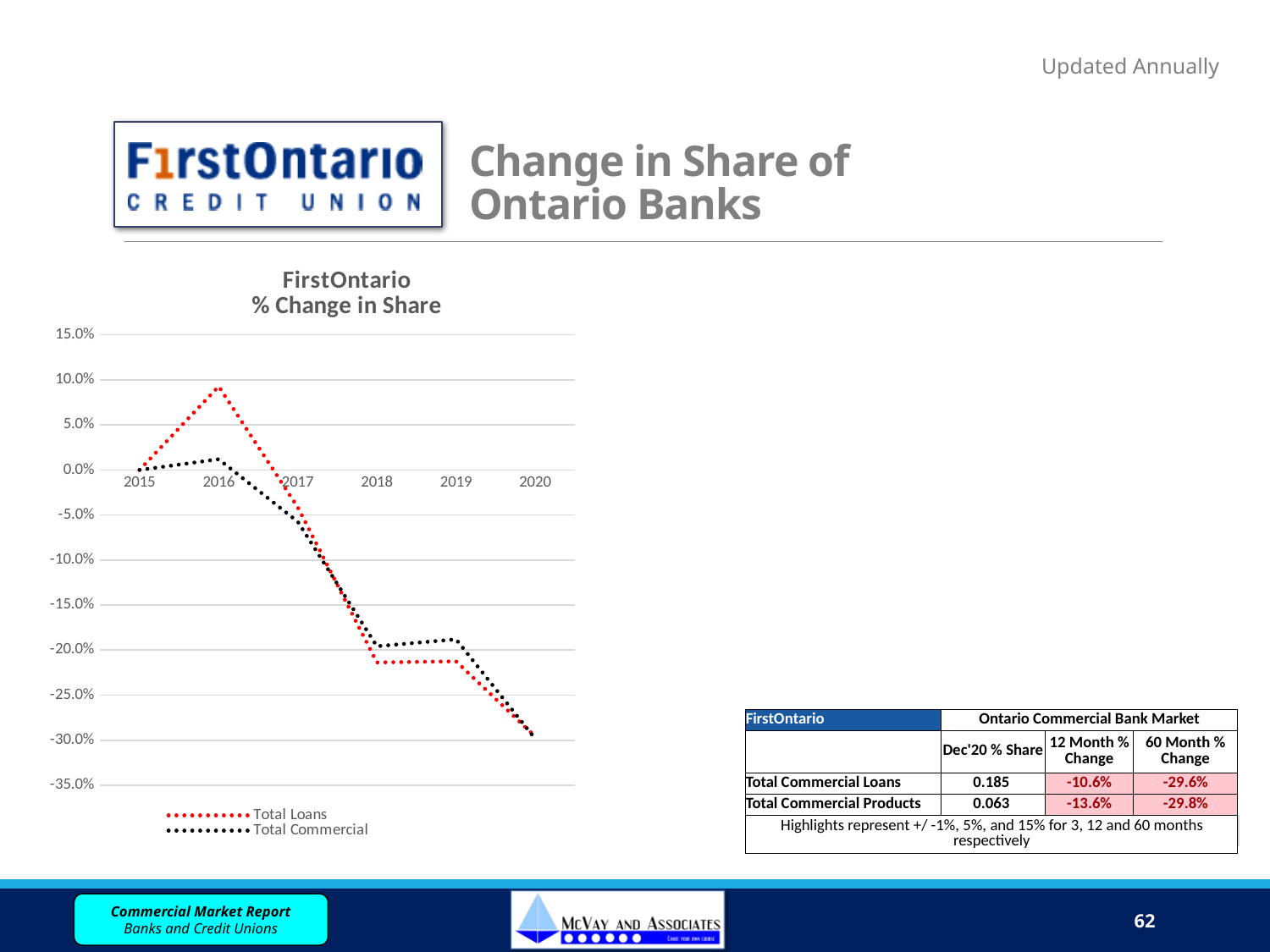
Is the value for Total Loans in 2016 greater or less than 5.0%? greater Is the value for Total Loans in 2018 greater or less than -20.0%? less In which year is the Total Commercial series at its lowest? 2020 What is the title of the chart? FirstOntario % Change in Share Do the values for Total Commercial generally rise or fall from 2015 to 2020? fall In 2016, which series has the larger value, Total Loans or Total Commercial? Total Loans In which year is the Total Loans series at its highest? 2016 How many years are shown along the x axis of the chart? 6 Which series is drawn in red in the chart? Total Loans What kind of chart is shown on the slide? line chart Is the value for Total Commercial in 2020 greater or less than -25.0%? less How many series does the legend of the chart list? 2